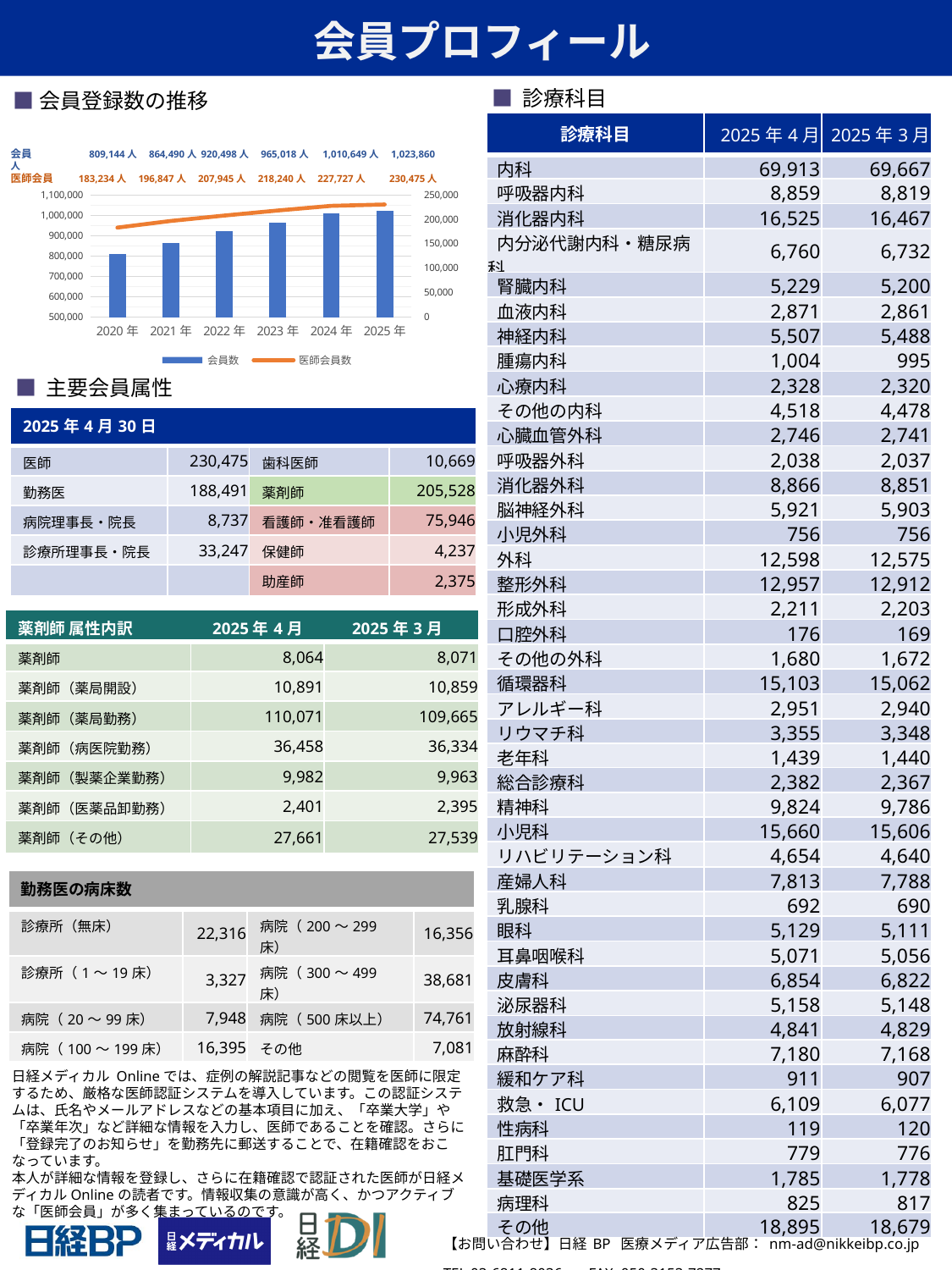
In the 会員登録数の推移 chart, what is the 医師会員 value for 2025年? 230,475人 In the 会員登録数の推移 chart, what is the difference between the 医師会員 values for 2025年 and 2024年? 2,748 In the 会員登録数の推移 chart, do the 会員数 values rise or fall from 2020年 to 2025年? rise In the 会員登録数の推移 chart, what is the 医師会員 value for 2022年? 207,945人 In the 会員登録数の推移 chart, how many years are shown on the x axis? 6 In the 会員登録数の推移 chart, which year has the highest 会員数? 2025年 In the 会員登録数の推移 chart, which year has the lowest 医師会員数? 2020年 In the 会員登録数の推移 chart, what is the difference between the 会員 values for 2025年 and 2020年? 214,716 In the 会員登録数の推移 chart, is the 会員数 bar for 2020年 greater or less than 900,000? less In the 会員登録数の推移 chart, what is the 会員 value for 2020年? 809,144人 What kind of chart is the 会員登録数の推移 chart? bar and line chart In the 会員登録数の推移 chart, how many series does the legend list? 2